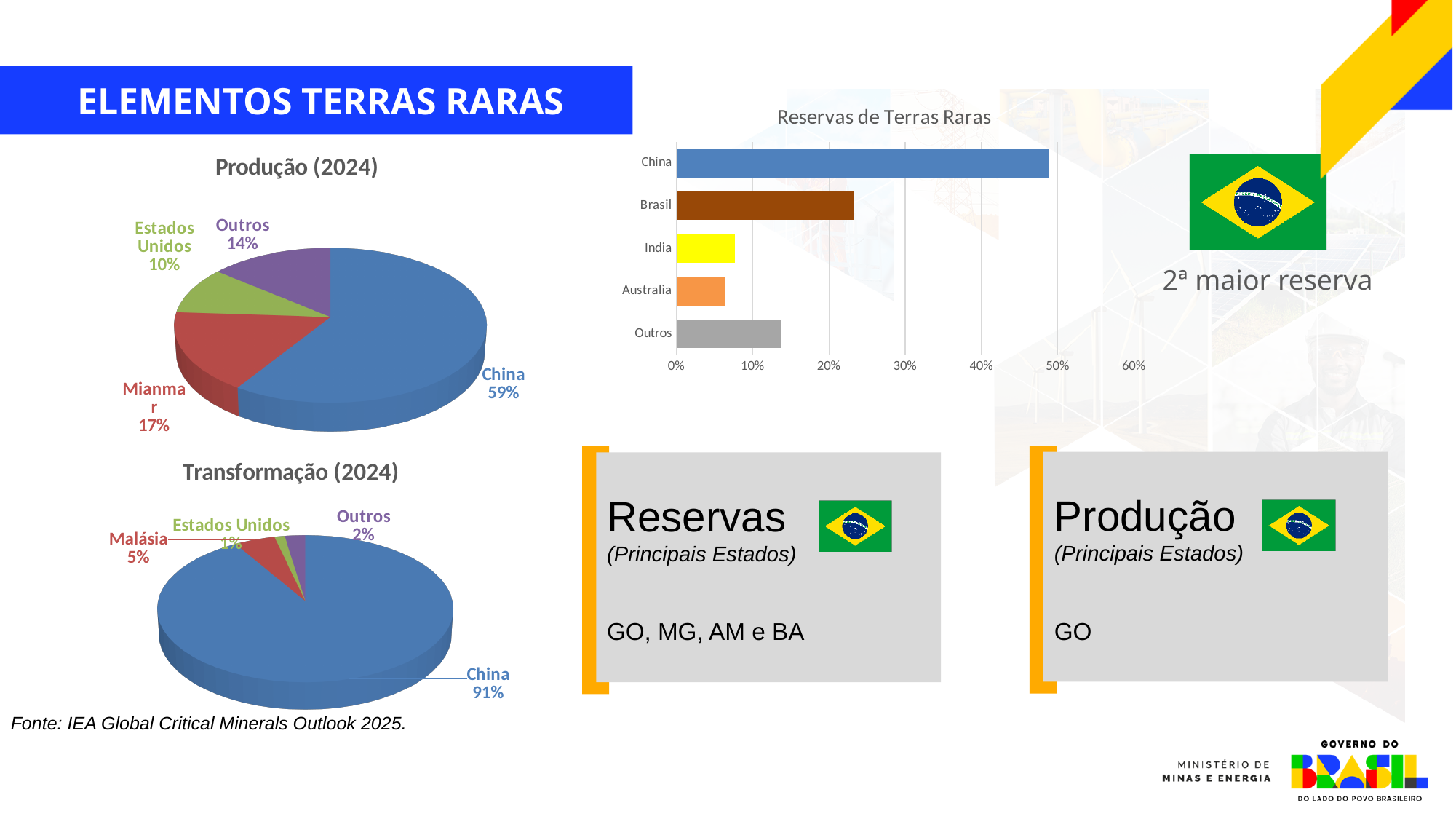
In the Produção (2024) chart, what share does Mianmar have? 17% In the Produção (2024) chart, what share does China have? 59% In the Reservas de Terras Raras chart, is the value for Australia greater or less than 10%? less In the Reservas de Terras Raras chart, is the value for Brasil greater or less than 20%? greater In the Produção (2024) chart, which category has the smallest share? Estados Unidos How many categories does the Transformação (2024) chart show? 4 In the Produção (2024) chart, what is the difference between the shares of China and Outros? 45% What kind of chart is the Reservas de Terras Raras chart? Bar chart In the Transformação (2024) chart, which is larger, the share of Outros or the share of Estados Unidos? Outros In the Transformação (2024) chart, what share does China have? 91% In the Transformação (2024) chart, what share does Malásia have? 5% In the Reservas de Terras Raras chart, which country has the highest value? China